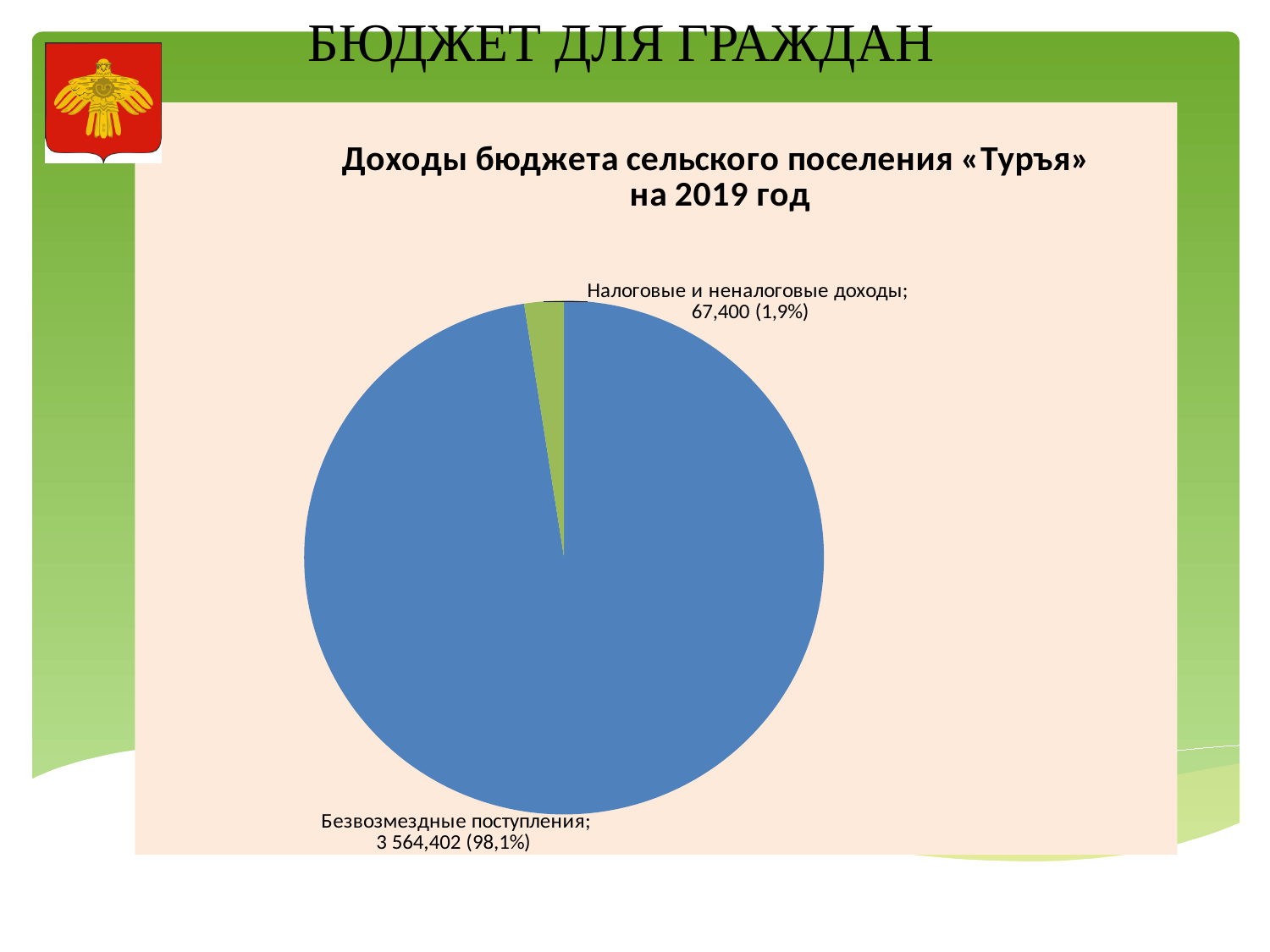
What is the value for «Налоговые и неналоговые доходы»? 67,400 What colour is the slice for «Налоговые и неналоговые доходы»? Green What is the difference between the values for «Безвозмездные поступления» and «Налоговые и неналоговые доходы»? 3 497,002 What share of the pie does «Налоговые и неналоговые доходы» take? 1,9% What kind of chart is shown on the slide? Pie chart How many categories (slices) does the pie chart have? 2 What is the value for «Безвозмездные поступления»? 3 564,402 Which category has the smallest slice of the pie? Налоговые и неналоговые доходы What share of the pie does «Безвозмездные поступления» take? 98,1% Which category has the largest slice of the pie? Безвозмездные поступления What is the title of the chart? Доходы бюджета сельского поселения «Туръя» на 2019 год Which is larger: «Безвозмездные поступления» or «Налоговые и неналоговые доходы»? Безвозмездные поступления